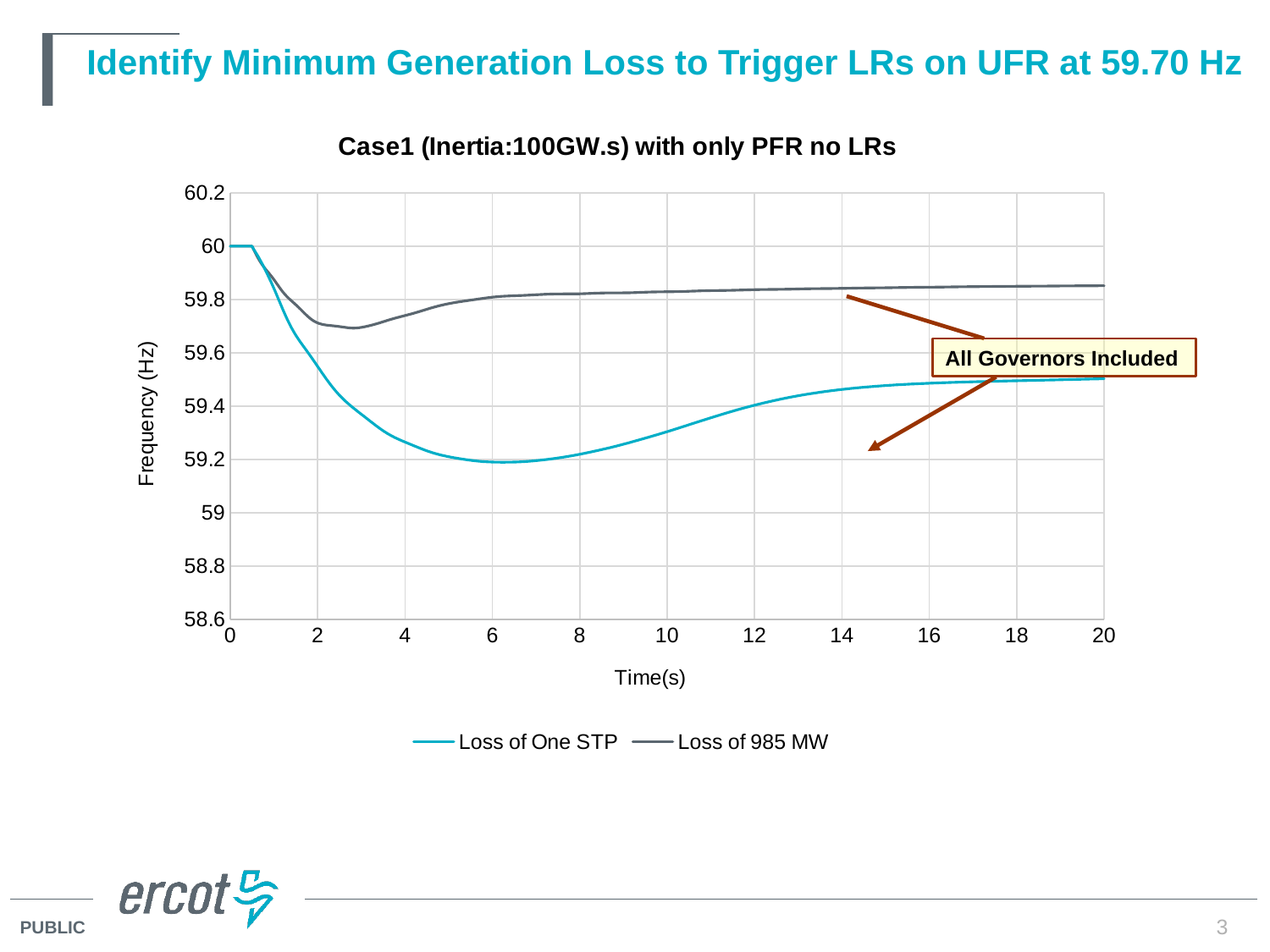
What is the title of the chart? Case1 (Inertia:100GW.s) with only PFR no LRs What text is shown in the annotation box on the chart? All Governors Included Does the Loss of 985 MW series rise or fall between time 0 and time 2? fall Is the value of the Loss of 985 MW series at time 20 greater or less than 59.8? greater Is the value of the Loss of One STP series at time 20 greater or less than 59.4? greater Does the Loss of One STP series rise or fall between time 8 and time 20? rise What kind of chart is shown on the slide? line chart What is the frequency value of both series at time 0? 60 Which series reaches the lower minimum frequency, Loss of One STP or Loss of 985 MW? Loss of One STP Is the minimum frequency reached by the Loss of 985 MW series greater or less than 59.6? greater How many series does the legend list? 2